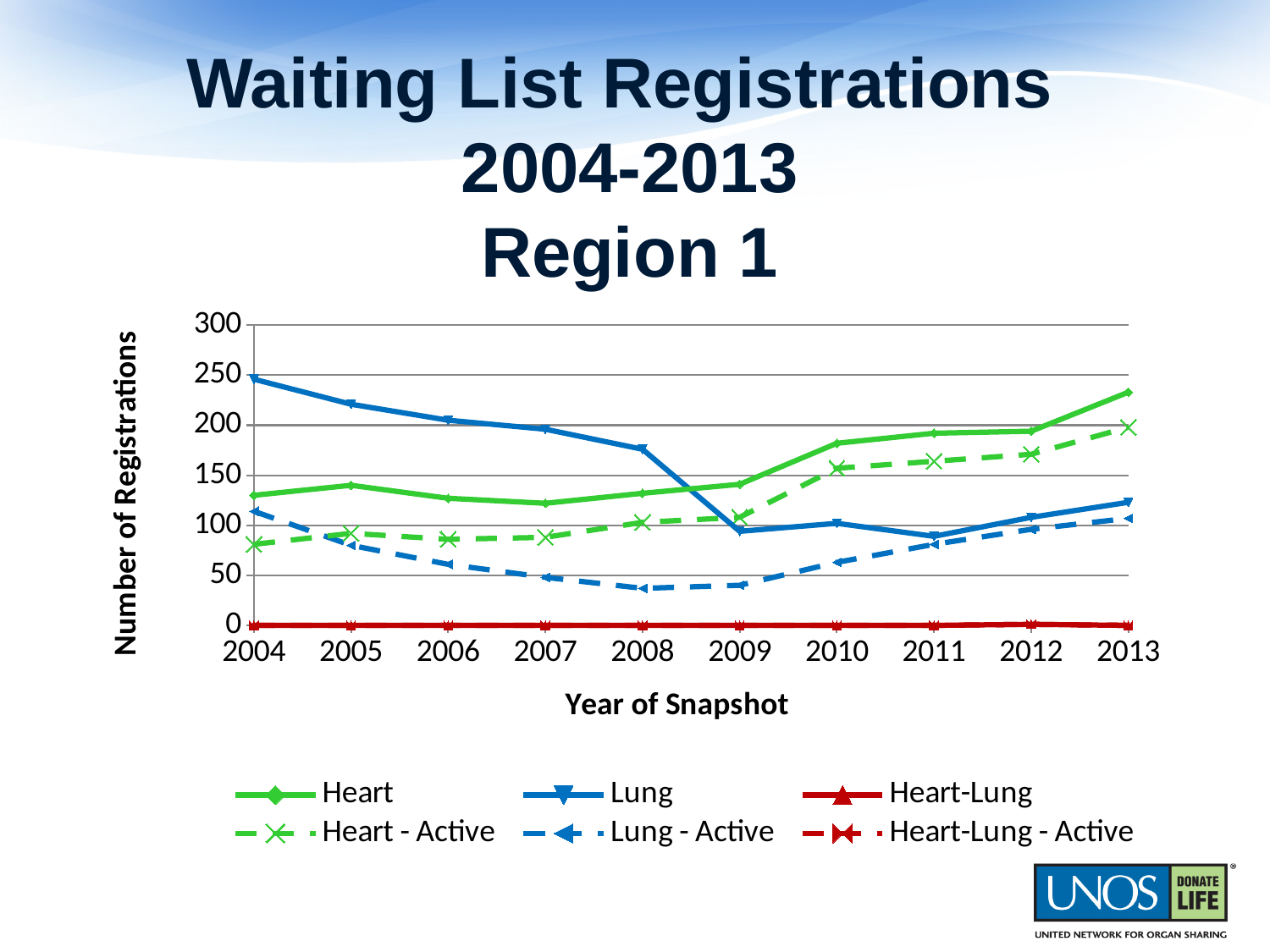
Is the value for Lung - Active in 2008 greater or less than 50? less Does the Lung series rise or fall from 2004 to 2009? fall How many series does the legend list? 6 What is the label of the y axis? Number of Registrations What kind of chart is shown on the slide? line chart How many years are plotted along the x axis? 10 Which series has the highest value in 2004? Lung Is the value for Lung in 2004 greater or less than 200? greater Is the value for Heart in 2013 greater or less than 200? greater In which year does the Lung series reach its highest value? 2004 In which year does the Heart series reach its highest value? 2013 Which is larger in 2013, the Heart value or the Lung value? Heart